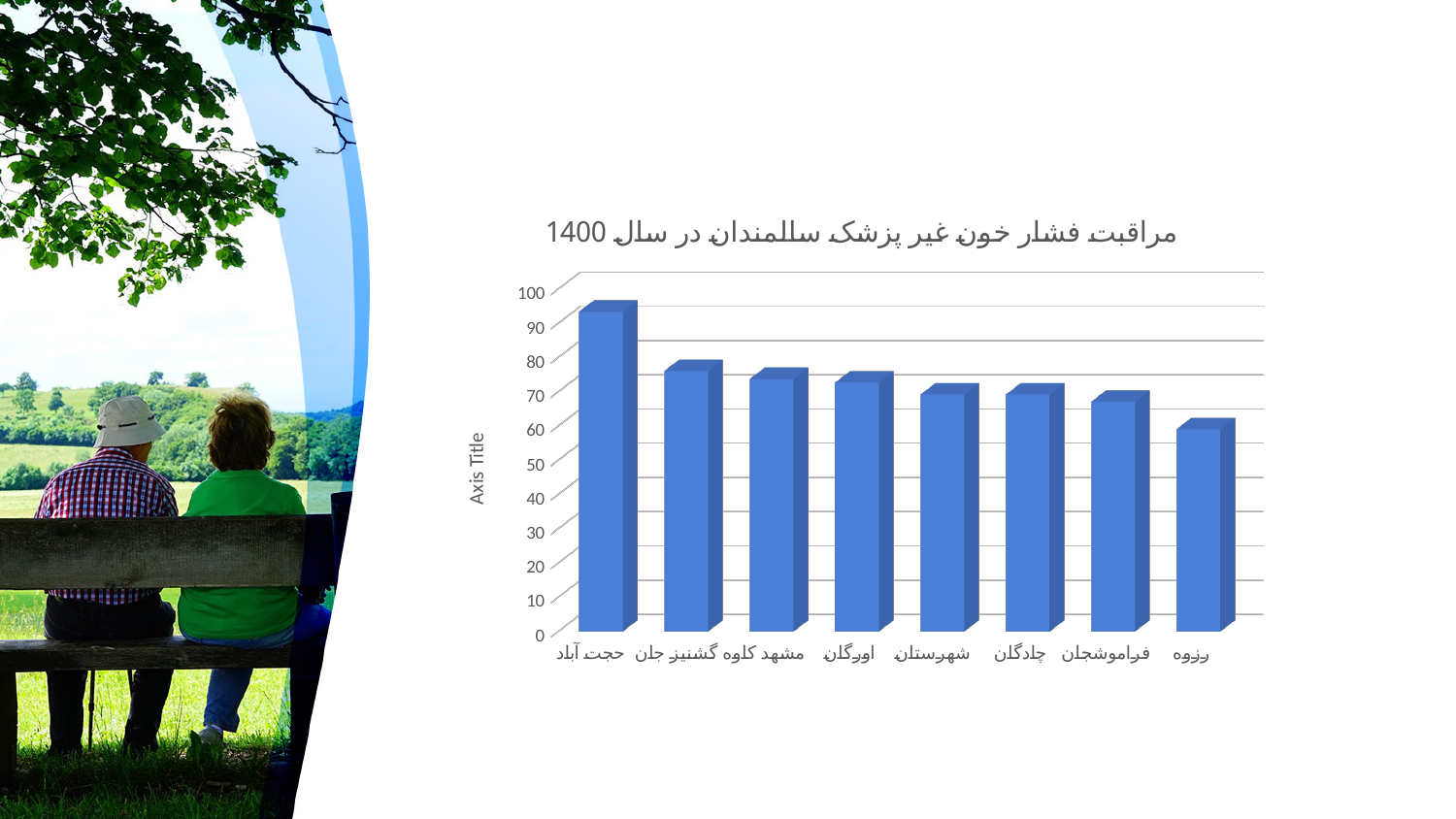
Which category has the lowest value in the chart? رزوه What is the title of the chart? مراقبت فشار خون غیر پزشک سالمندان در سال 1400 How many categories (bars) are plotted in the chart? 8 What kind of chart is shown on the slide? bar chart Do the values generally rise or fall moving from left to right across the categories? fall Which category has the highest value in the chart? حجت آباد Which is larger, the value for حجت آباد or the value for رزوه? حجت آباد Is the value for گشنیز جان greater or less than 70? greater Is the value for حجت آباد greater or less than 90? greater What is the label shown on the vertical axis of the chart? Axis Title